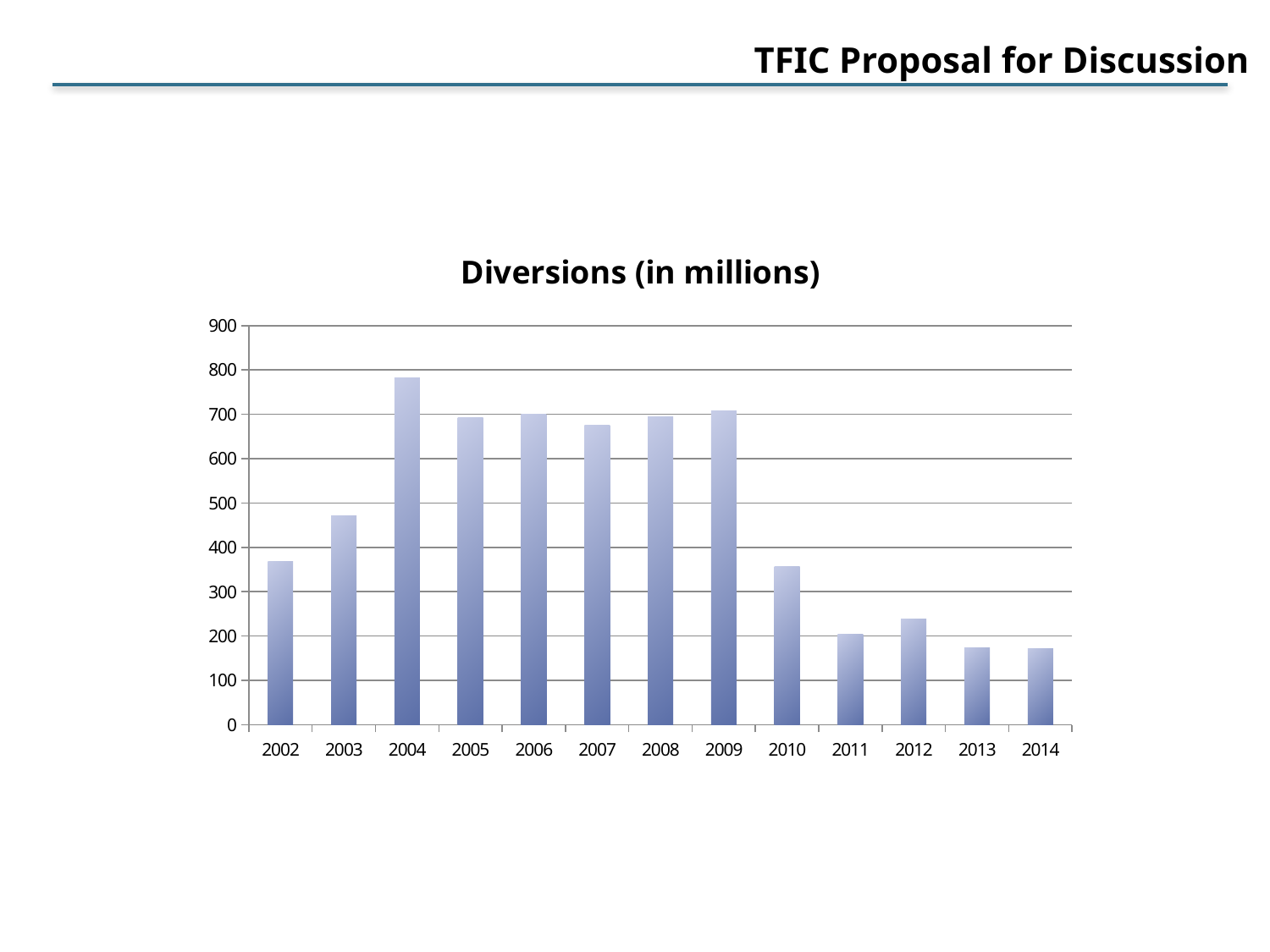
Which is larger, the value for 2003 or the value for 2010? 2003 Which year has the highest value in the chart? 2004 Is the value for 2002 greater or less than 400? less Do the values rise or fall from 2009 to 2014? fall What is the title of the chart? Diversions (in millions) Is the value for 2007 greater or less than 700? less What type of chart is shown on the slide? bar chart How many years are shown on the x axis of the chart? 13 Is the value for 2004 greater or less than 700? greater Which is larger, the value for 2011 or the value for 2012? 2012